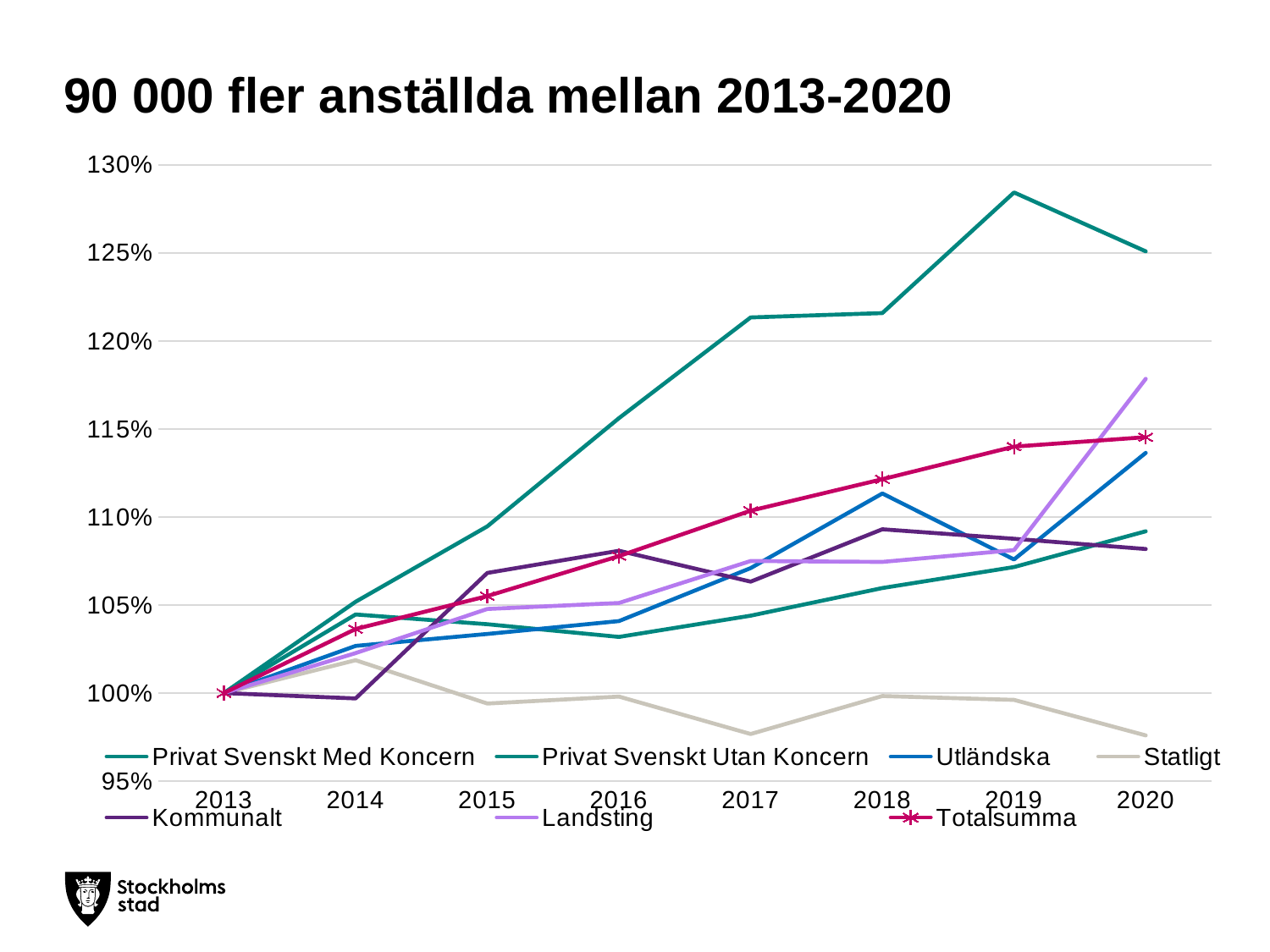
In which year does Privat Svenskt Med Koncern reach its highest value? 2019 Which series has the lowest value in 2020? Statligt How many series does the legend list? 7 How many years are plotted along the x axis? 8 Which series has the highest value in 2020? Privat Svenskt Med Koncern What is the value of Totalsumma in 2013? 100% Is the value for Landsting in 2020 greater or less than 115%? greater What is the title of the chart? 90 000 fler anställda mellan 2013-2020 Is the value for Privat Svenskt Med Koncern in 2019 greater or less than 125%? greater In 2020, which is larger: Utländska or Kommunalt? Utländska Is the value for Statligt in 2017 greater or less than 100%? less What kind of chart is shown on the slide? line chart